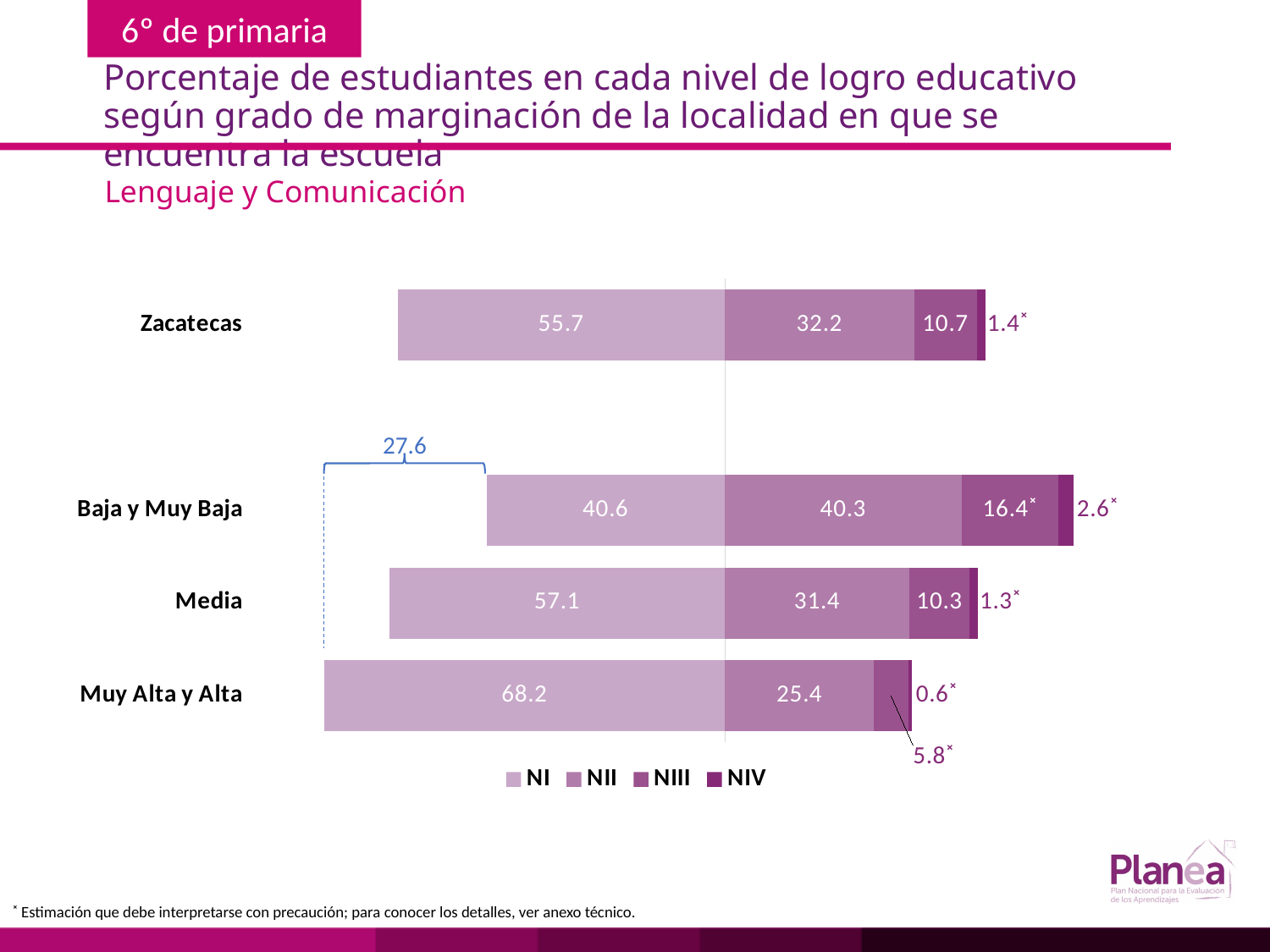
What kind of chart is shown on the slide? Stacked bar chart What is the NIII value for Media? 10.3 Which has a larger NII value, Zacatecas or Media? Zacatecas What is the NI value for Muy Alta y Alta? 68.2 Which category has the lowest NI value? Baja y Muy Baja How many series does the legend list? 4 Which category has the highest NI value? Muy Alta y Alta What are the four legend entries of the chart? NI, NII, NIII, NIV What is the difference between the NI value for Muy Alta y Alta and the NI value for Baja y Muy Baja? 27.6 What is the NII value for Baja y Muy Baja? 40.3 How many categories (bars) are plotted in the chart? 4 What is the NI value for Zacatecas? 55.7